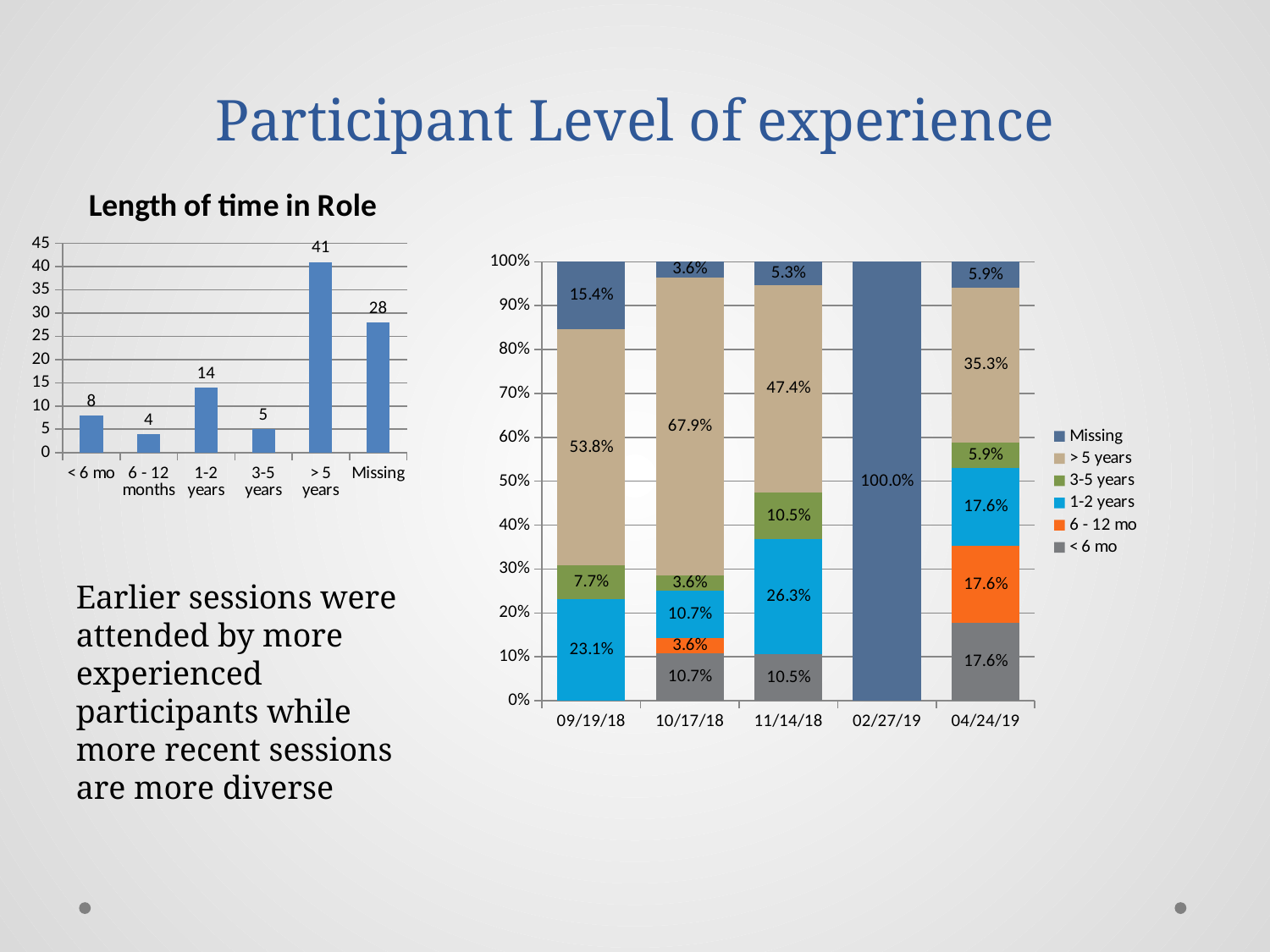
In the 'Length of time in Role' chart, which is larger, the value for '< 6 mo' or the value for '3-5 years'? < 6 mo In the stacked bar chart on the right, what is the value for 'Missing' on 02/27/19? 100.0% In the 'Length of time in Role' chart, what is the value for '> 5 years'? 41 In the stacked bar chart on the right, what is the difference between the '> 5 years' values on 09/19/18 and 04/24/19? 18.5% What kind of chart is the chart on the right of the slide? Stacked bar chart In the stacked bar chart on the right, what is the value for '> 5 years' on 10/17/18? 67.9% In the 'Length of time in Role' chart, which category has the highest value? > 5 years In the 'Length of time in Role' chart, how many categories are shown on the x axis? 6 In the 'Length of time in Role' chart, what is the difference between the values for '> 5 years' and 'Missing'? 13 In the stacked bar chart on the right, how many series does the legend list? 6 In the 'Length of time in Role' chart, which category has the lowest value? 6 - 12 months In the stacked bar chart on the right, what is the value for '1-2 years' on 11/14/18? 26.3%